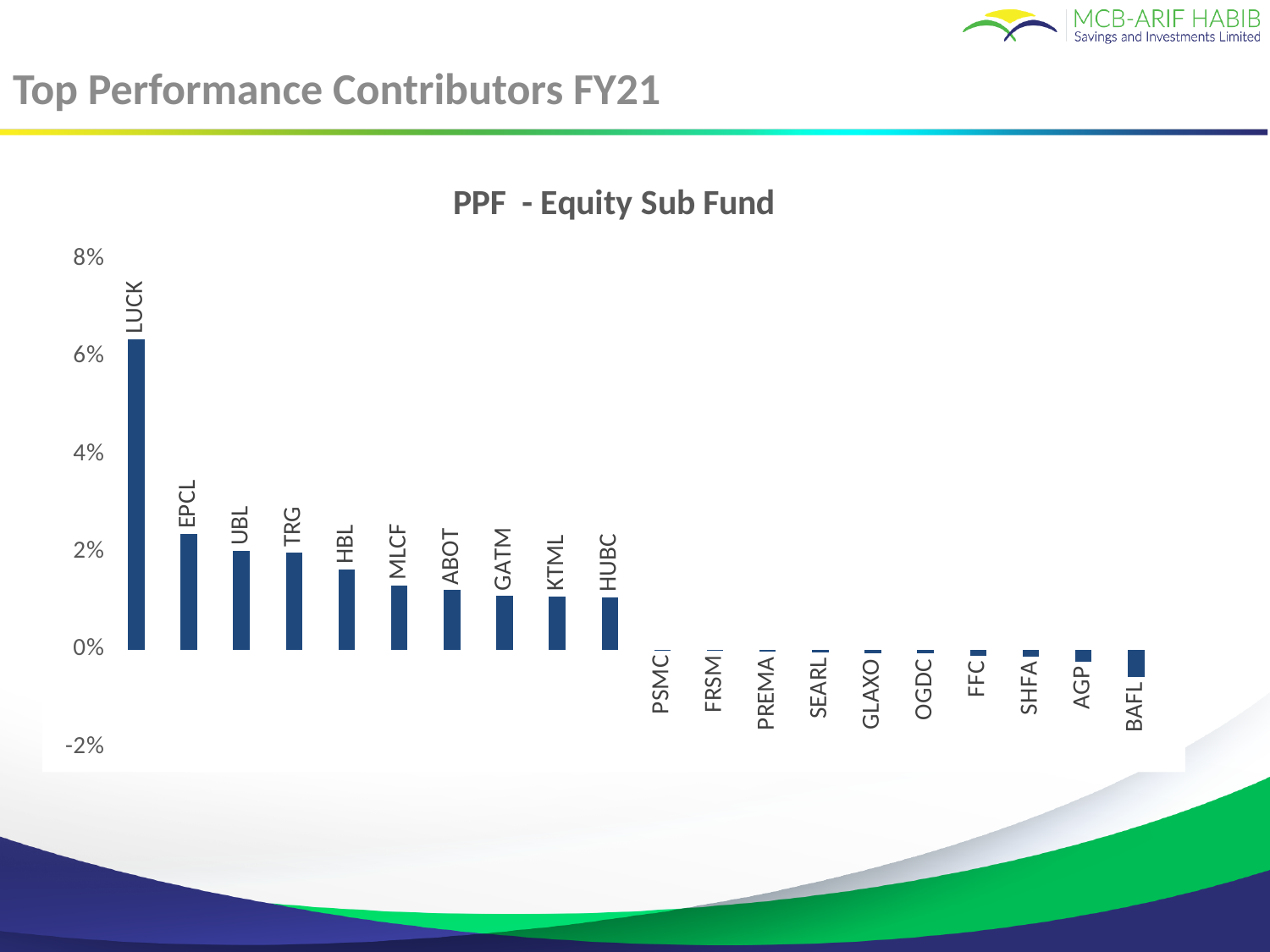
Which category has the highest value? LUCK Is the value for LUCK greater or less than 6%? greater Is the value for EPCL greater or less than 2%? greater Which is larger, the value for LUCK or the value for EPCL? LUCK Is the value for HBL greater or less than 2%? less Do the values generally rise or fall moving from left to right along the x axis? fall How many categories are plotted on the chart? 20 Which category has the lowest value? BAFL What is the title of the chart? PPF - Equity Sub Fund Which is larger, the value for HBL or the value for HUBC? HBL What type of chart is shown on the slide? Bar chart